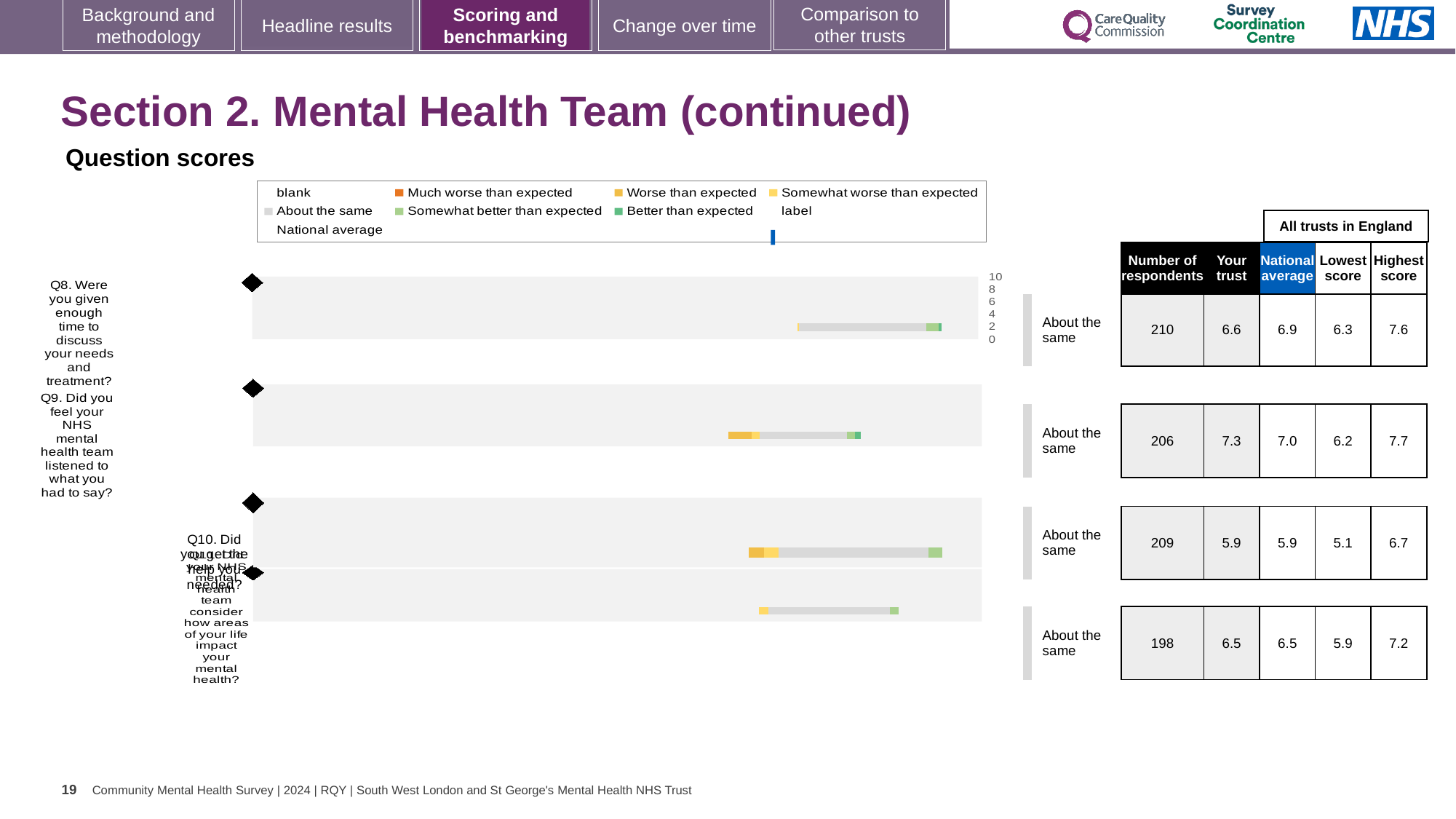
In the table beside the chart, what is the 'Your trust' score for Q9 (Did you feel your NHS mental health team listened to what you had to say?)? 7.3 For Q8, which is larger: the 'Your trust' score or the national average? National average How many respondents are listed for Q10 (Did you get the help you needed?)? 209 Which question has the lowest 'Your trust' score in the table? Q10 What is the highest score across all trusts in England for Q9? 7.7 In the table beside the chart, what is the national average for Q8 (Were you given enough time to discuss your needs and treatment?)? 6.9 What is the difference between the 'Your trust' score and the national average for Q9? 0.3 What is the lowest score across all trusts in England for Q10? 5.1 How many questions (bars) are plotted in the question scores chart? 4 Which question has the highest 'Your trust' score in the table? Q9 What kind of chart is used to show the question scores on this slide? bar chart What benchmark label is shown next to the bar for Q11 (Did your NHS mental health team consider how areas of your life impact your mental health?)? About the same